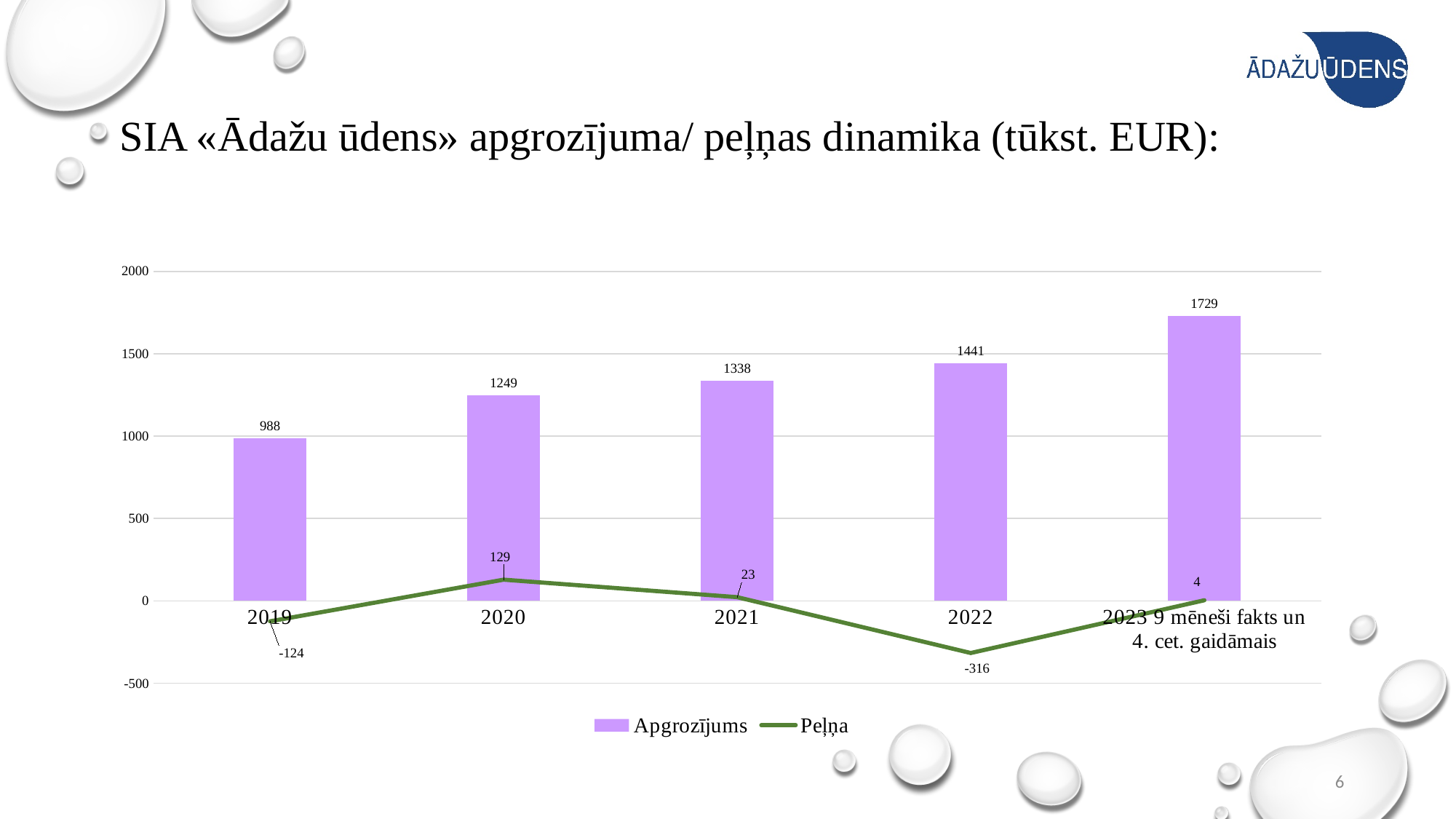
How many years are shown on the x axis? 5 What is the Peļņa value for 2022? -316 Which year has the lowest Peļņa? 2022 What is the Peļņa value for 2020? 129 Does the Apgrozījums rise or fall from 2019 to 2023? rise Which year has the highest Apgrozījums? 2023 9 mēneši fakts un 4. cet. gaidāmais Which is larger, the Peļņa for 2021 or for 2023? 2021 What colour are the Apgrozījums bars? purple What is the difference between the Apgrozījums for 2020 and 2019? 261 Is the Apgrozījums for 2022 greater or less than 1500? less What is the Apgrozījums value for 2021? 1338 How many series does the legend list? 2